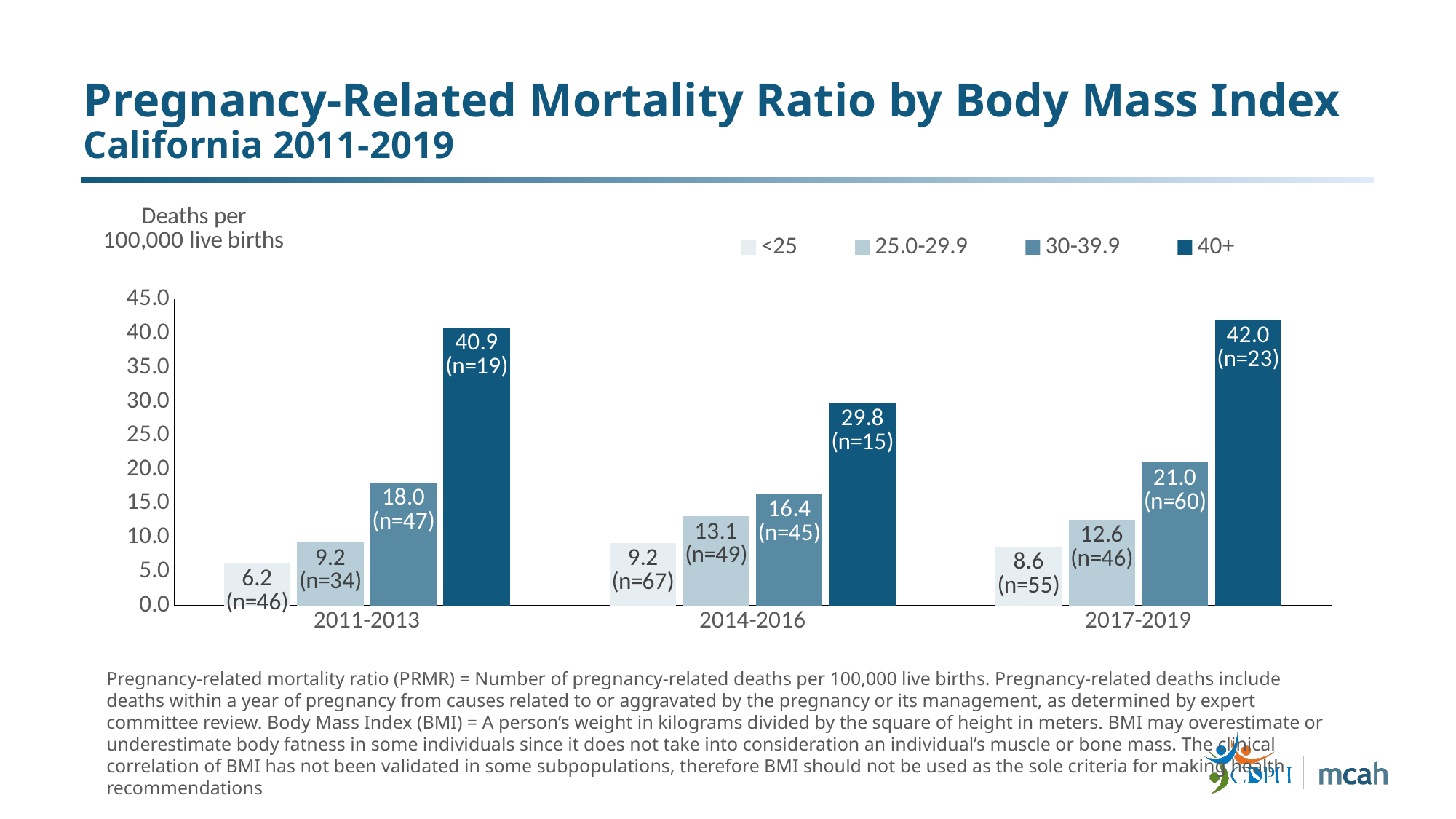
Which is larger: the 25.0-29.9 mortality ratio in 2014-2016 or in 2017-2019? 2014-2016 What is the pregnancy-related mortality ratio for the <25 BMI group in 2014-2016? 9.2 What is the unit shown on the y axis of the chart? Deaths per 100,000 live births What type of chart is shown on the slide? Bar chart What is the pregnancy-related mortality ratio for the 30-39.9 BMI group in 2017-2019? 21.0 How many BMI groups does the legend list? 4 What is the difference between the 40+ and 30-39.9 mortality ratios in 2014-2016? 13.4 Which BMI group has the lowest mortality ratio in 2011-2013? <25 What is the pregnancy-related mortality ratio for the 40+ BMI group in 2011-2013? 40.9 Which BMI group has the highest mortality ratio in 2017-2019? 40+ How many time periods are shown on the x axis? 3 How many pregnancy-related deaths (n) are reported for the 25.0-29.9 BMI group in 2017-2019? n=46